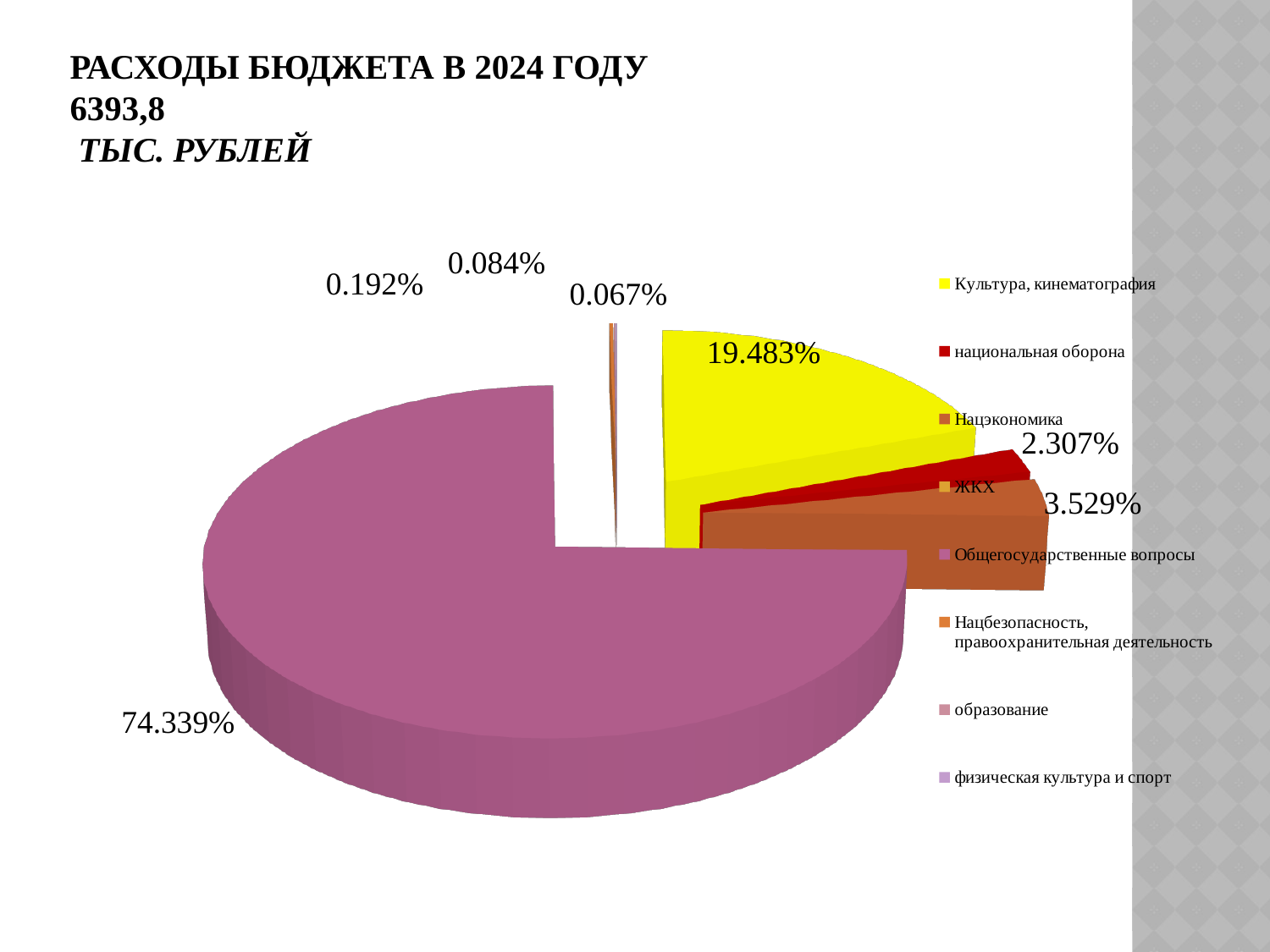
What percentage is shown for национальная оборона? 2.307% What is the difference in percentage points between Общегосударственные вопросы and Культура, кинематография? 54.856% How many categories does the legend list? 8 Which category has the largest slice of the pie? Общегосударственные вопросы What share of the pie does Общегосударственные вопросы account for? 74.339% What kind of chart is shown on the slide? Pie chart Which is larger, the share for Нацэкономика or the share for национальная оборона? Нацэкономика What colour is the slice for Культура, кинематография? Yellow What is the title of the slide? РАСХОДЫ БЮДЖЕТА В 2024 ГОДУ What percentage is shown for Культура, кинематография? 19.483% What percentage is shown for Нацэкономика? 3.529% What is the smallest percentage label shown on the pie chart? 0.067%